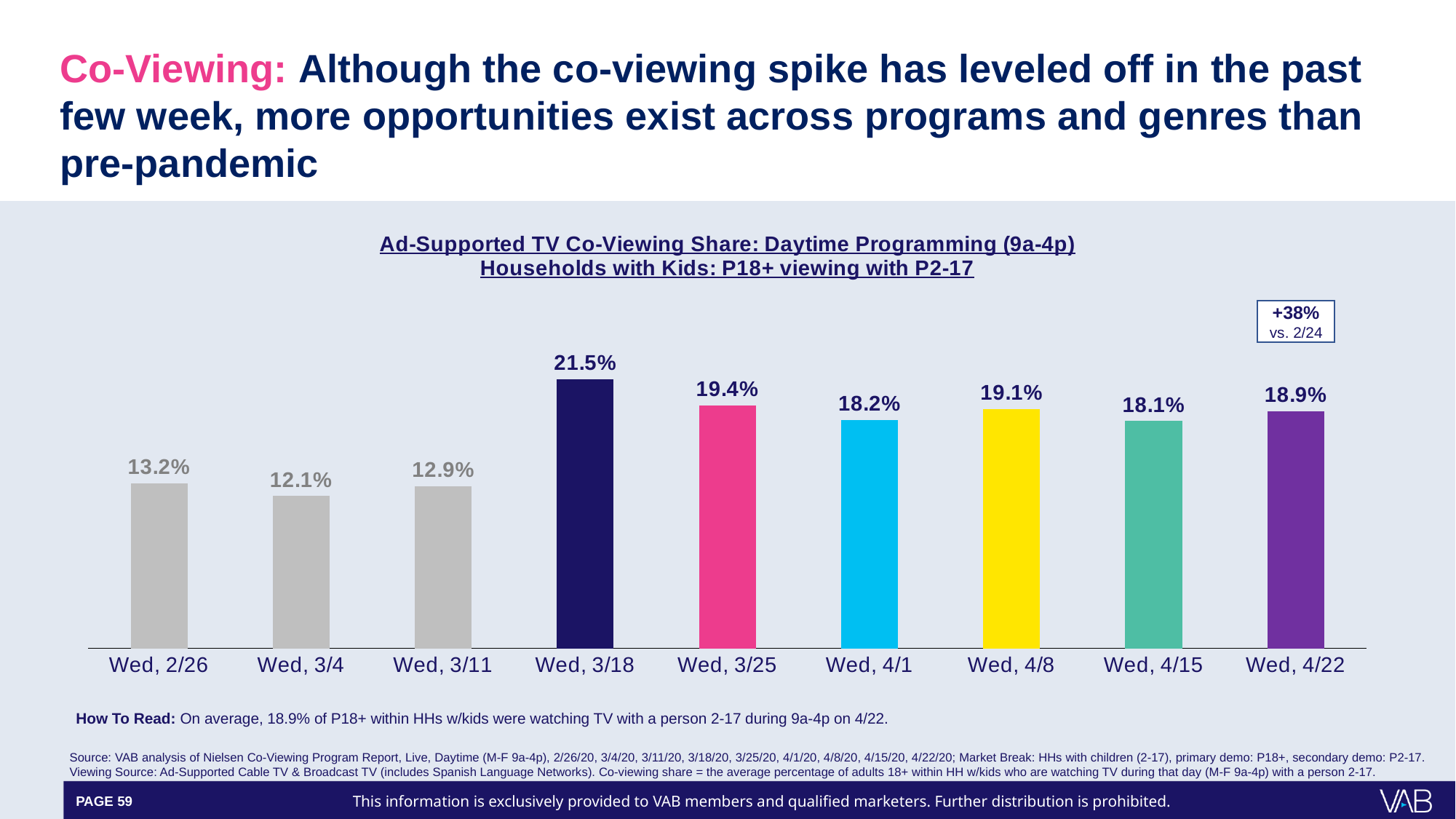
Which date has the lowest co-viewing share? Wed, 3/4 Which date has the highest co-viewing share? Wed, 3/18 What is the co-viewing share for Wed, 4/22? 18.9% Which has a higher co-viewing share, Wed, 3/25 or Wed, 4/8? Wed, 3/25 How many dates are shown on the chart? 9 Does the co-viewing share rise or fall from Wed, 3/11 to Wed, 3/18? Rise What is the co-viewing share for Wed, 3/18? 21.5% What is the difference in co-viewing share between Wed, 3/18 and Wed, 2/26? 8.3% What percentage change versus 2/24 is shown in the callout box above the Wed, 4/22 bar? +38% What type of chart is shown on the slide? Bar chart What is the co-viewing share for Wed, 3/4? 12.1% What is the title of the chart? Ad-Supported TV Co-Viewing Share: Daytime Programming (9a-4p) Households with Kids: P18+ viewing with P2-17